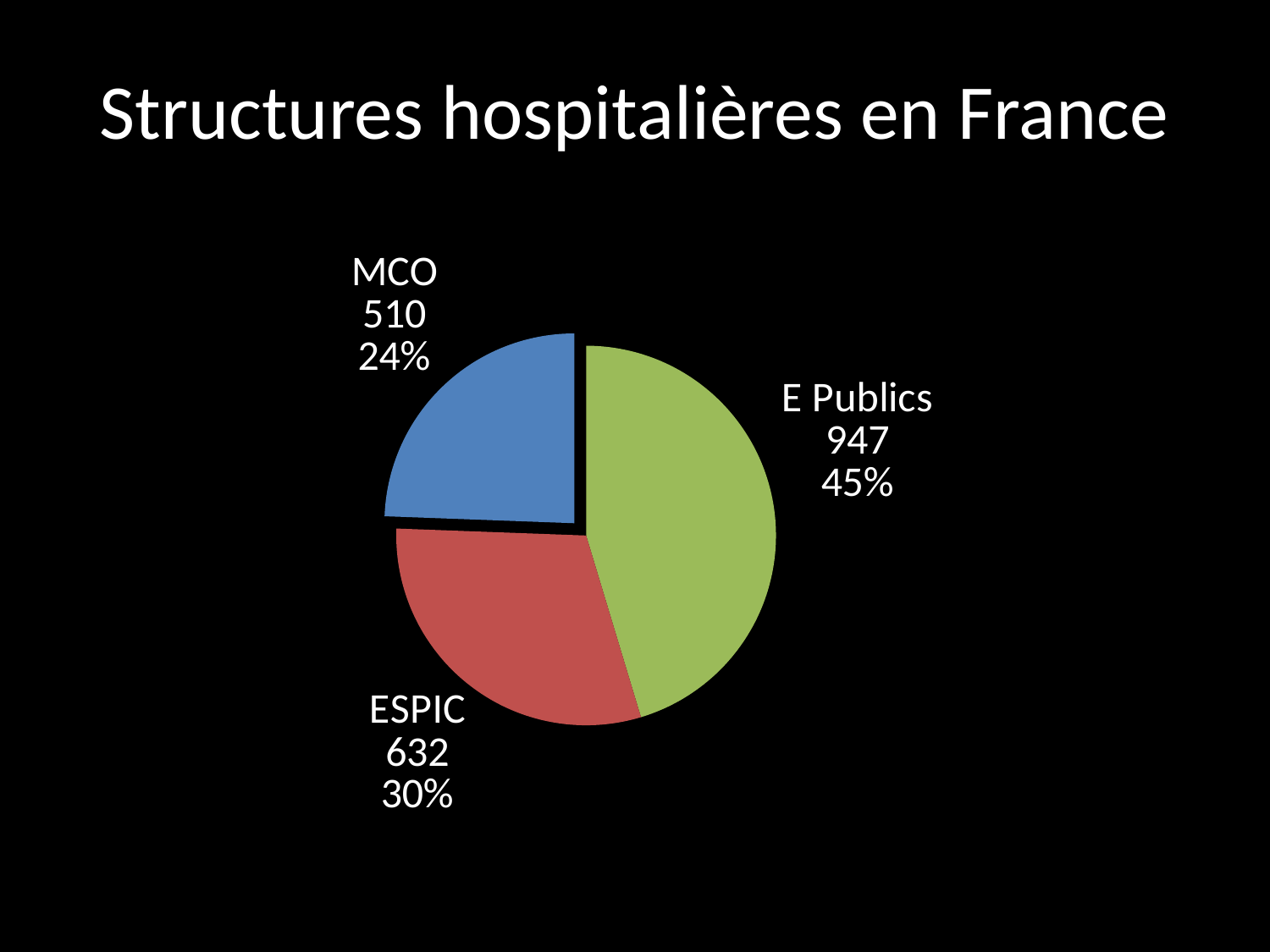
What is the value for ESPIC? 632 Which category has the largest slice? E Publics What is the title of the slide? Structures hospitalières en France What is the value for MCO? 510 What share of the pie does MCO represent? 24% What is the value for E Publics? 947 Which is larger, the value for ESPIC or the value for MCO? ESPIC What is the difference between the values for E Publics and ESPIC? 315 How many categories are shown in the pie chart? 3 What share of the pie does E Publics represent? 45% What type of chart is shown on the slide? pie chart Which category has the smallest slice? MCO